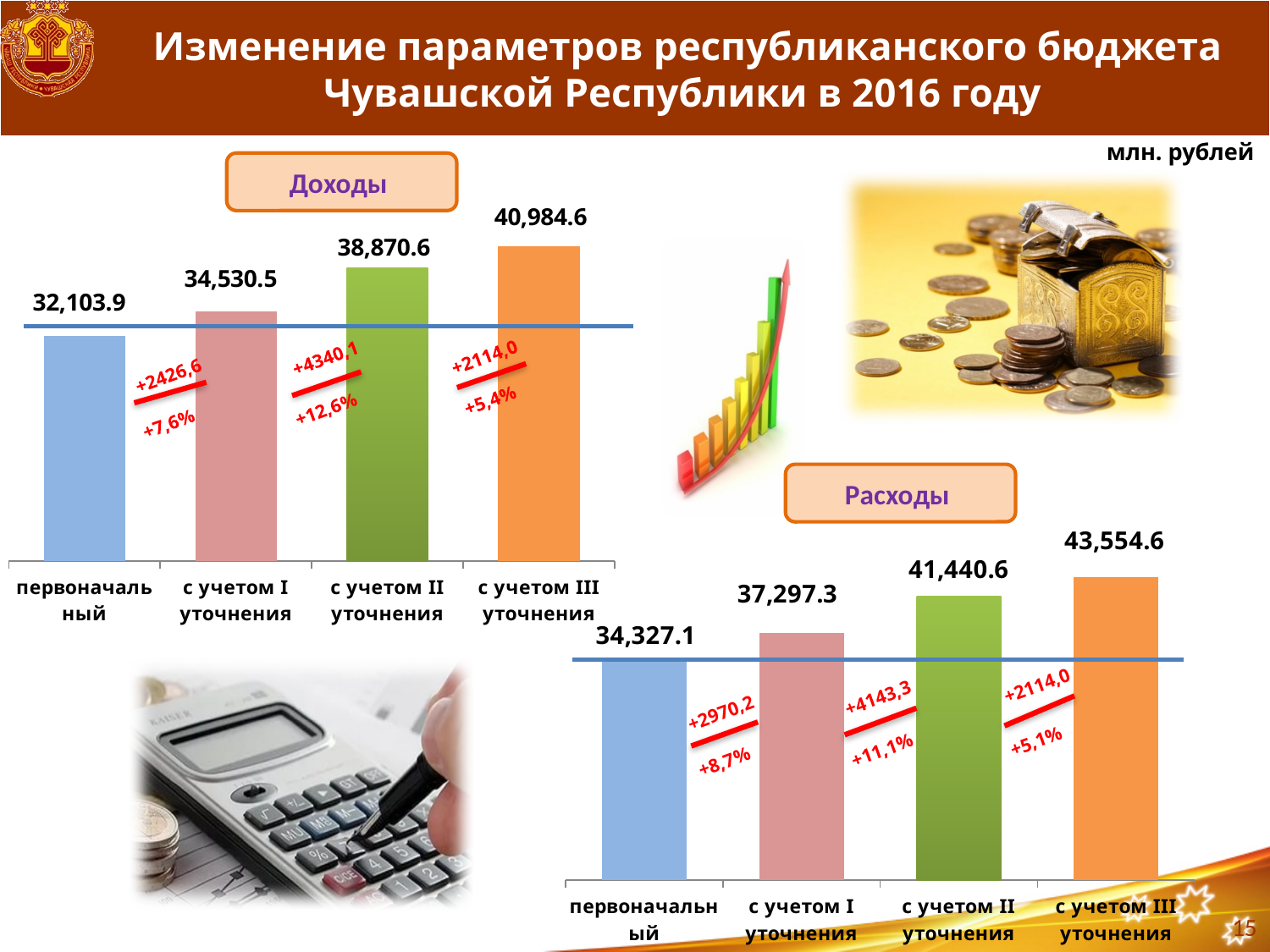
What kind of chart is the "Доходы" chart? bar chart On the "Расходы" chart, what is the difference between "с учетом II уточнения" and "с учетом I уточнения"? 4,143.3 On the "Расходы" chart, do the values rise or fall from left to right? rise On the "Расходы" chart, what is the value for "с учетом I уточнения"? 37,297.3 On the "Доходы" chart, which category has the highest value? с учетом III уточнения On the "Доходы" chart, what is the value for "с учетом II уточнения"? 38,870.6 On the "Расходы" chart, what is the value for "с учетом III уточнения"? 43,554.6 On the "Доходы" chart, what is the value for "первоначальный"? 32,103.9 On the "Доходы" chart, what is the difference between "с учетом III уточнения" and "первоначальный"? 8,880.7 On the "Расходы" chart, which category has the lowest value? первоначальный Which is larger: "с учетом III уточнения" on the "Доходы" chart or "с учетом III уточнения" on the "Расходы" chart? Расходы How many categories are shown on the "Расходы" chart? 4